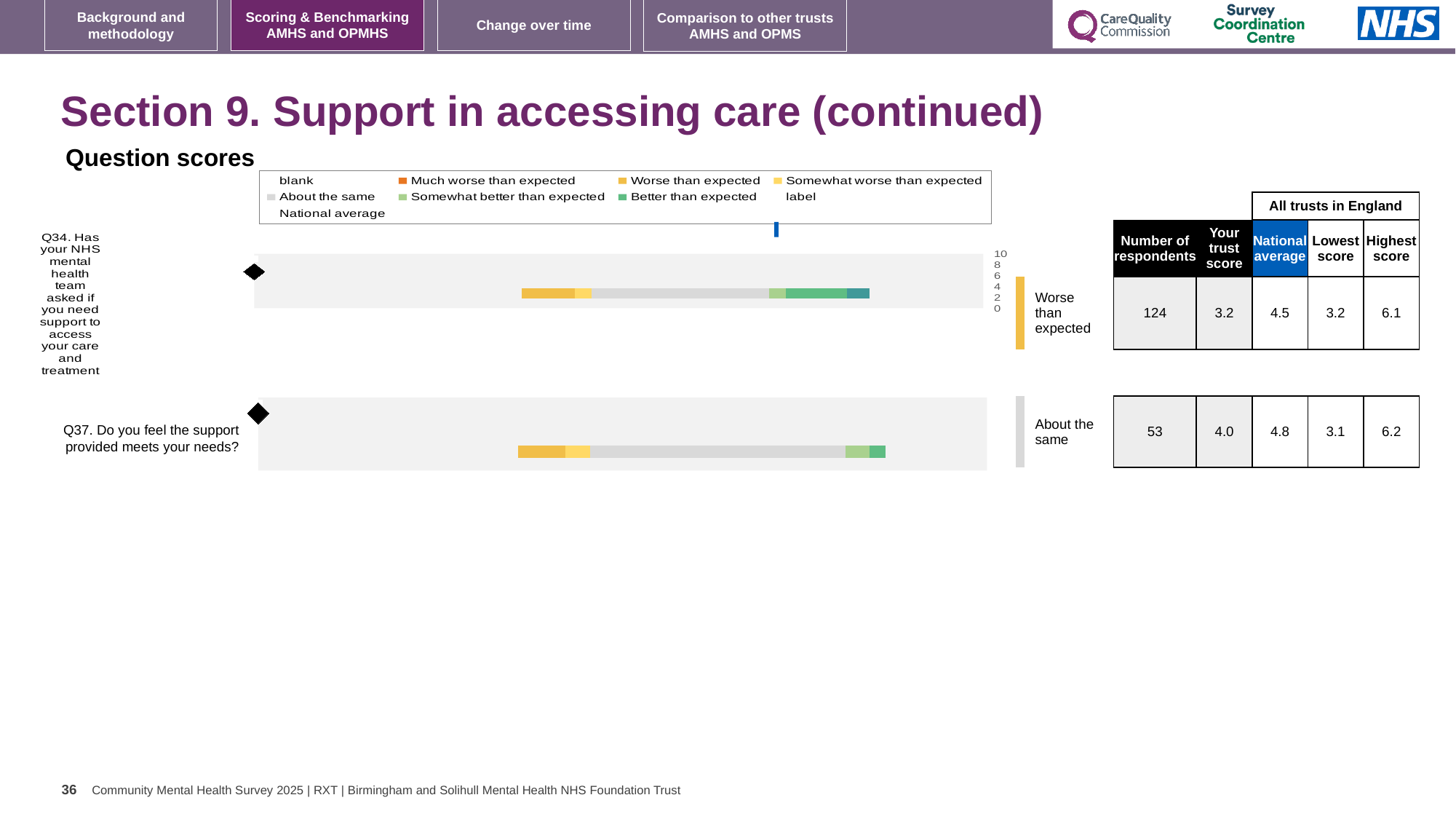
What kind of chart is used to show the question scores for Q34 and Q37? bar chart Which benchmark category is shown next to the bar for Q37? About the same What is the difference between the national average and the trust score for Q34? 1.3 How many respondents answered Q37 according to the table beside the chart? 53 Which legend entry in the question scores chart is shown in orange? Much worse than expected How many questions are plotted in the question scores chart? 2 What colour is the 'About the same' legend entry in the question scores chart? grey What is the trust score for Q34 shown in the table beside the chart? 3.2 What is the trust score for Q37 shown in the table beside the chart? 4.0 What is the national average for Q34 shown in the table beside the chart? 4.5 Which benchmark category is shown next to the bar for Q34? Worse than expected Which question has the higher trust score, Q34 or Q37? Q37